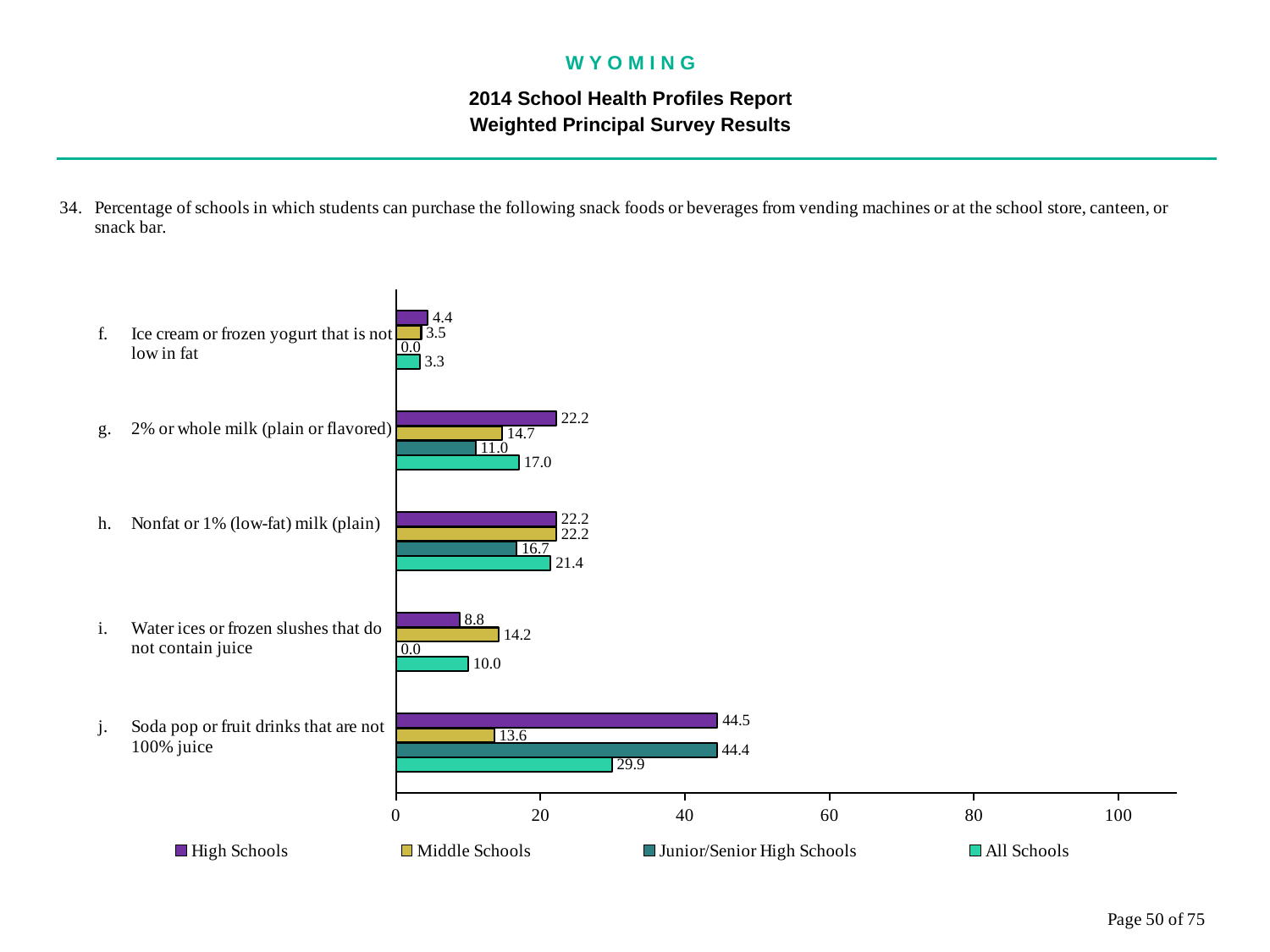
What is the difference between the High Schools and Middle Schools values for 'Soda pop or fruit drinks that are not 100% juice'? 30.9 How many snack food or beverage categories are shown on the chart? 5 How many series does the legend list? 4 What kind of chart is shown on the slide? Bar chart For 'Water ices or frozen slushes that do not contain juice', which is larger: the High Schools value or the Middle Schools value? Middle Schools Which category has the highest value for All Schools? Soda pop or fruit drinks that are not 100% juice What is the value for Junior/Senior High Schools for 'Water ices or frozen slushes that do not contain juice'? 0.0 Which series is shown in purple in the legend? High Schools What is the value for All Schools for 'Nonfat or 1% (low-fat) milk (plain)'? 21.4 Which category has the lowest value for High Schools? Ice cream or frozen yogurt that is not low in fat What is the value for Middle Schools for '2% or whole milk (plain or flavored)'? 14.7 What is the value for High Schools for 'Soda pop or fruit drinks that are not 100% juice'? 44.5